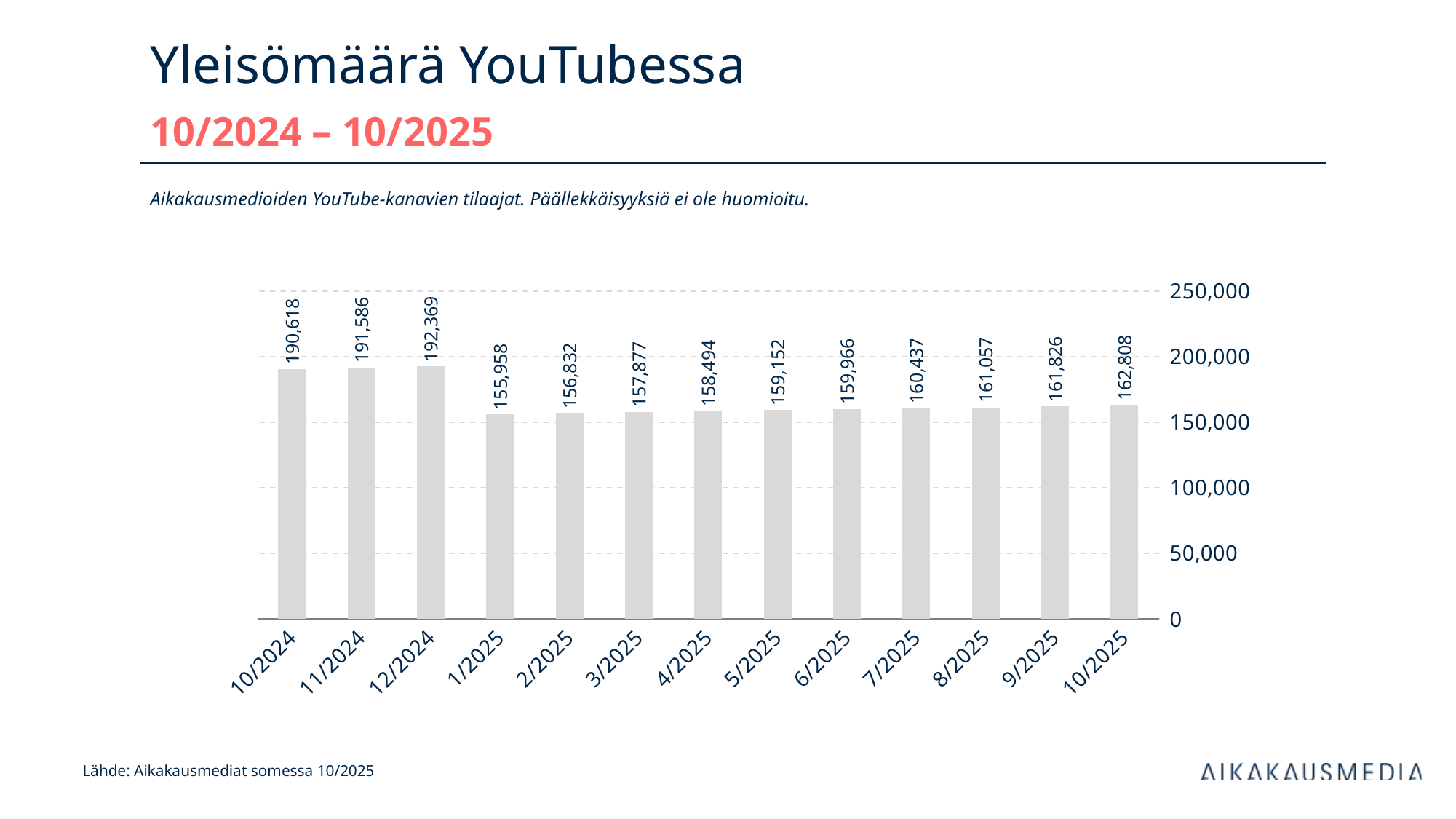
Which month has the lowest value? 1/2025 What is the difference between the values for 12/2024 and 1/2025? 36,411 How many months are shown on the x axis? 13 From 1/2025 to 10/2025, do the values rise or fall? rise What is the value for 1/2025? 155,958 What is the value for 10/2025? 162,808 What is the value for 10/2024? 190,618 What is the title of the chart on the slide? Yleisömäärä YouTubessa Which month has the highest value? 12/2024 What kind of chart is shown on the slide? bar chart Which is larger, the value for 11/2024 or the value for 9/2025? 11/2024 Is the value for 5/2025 greater or less than 200,000? less